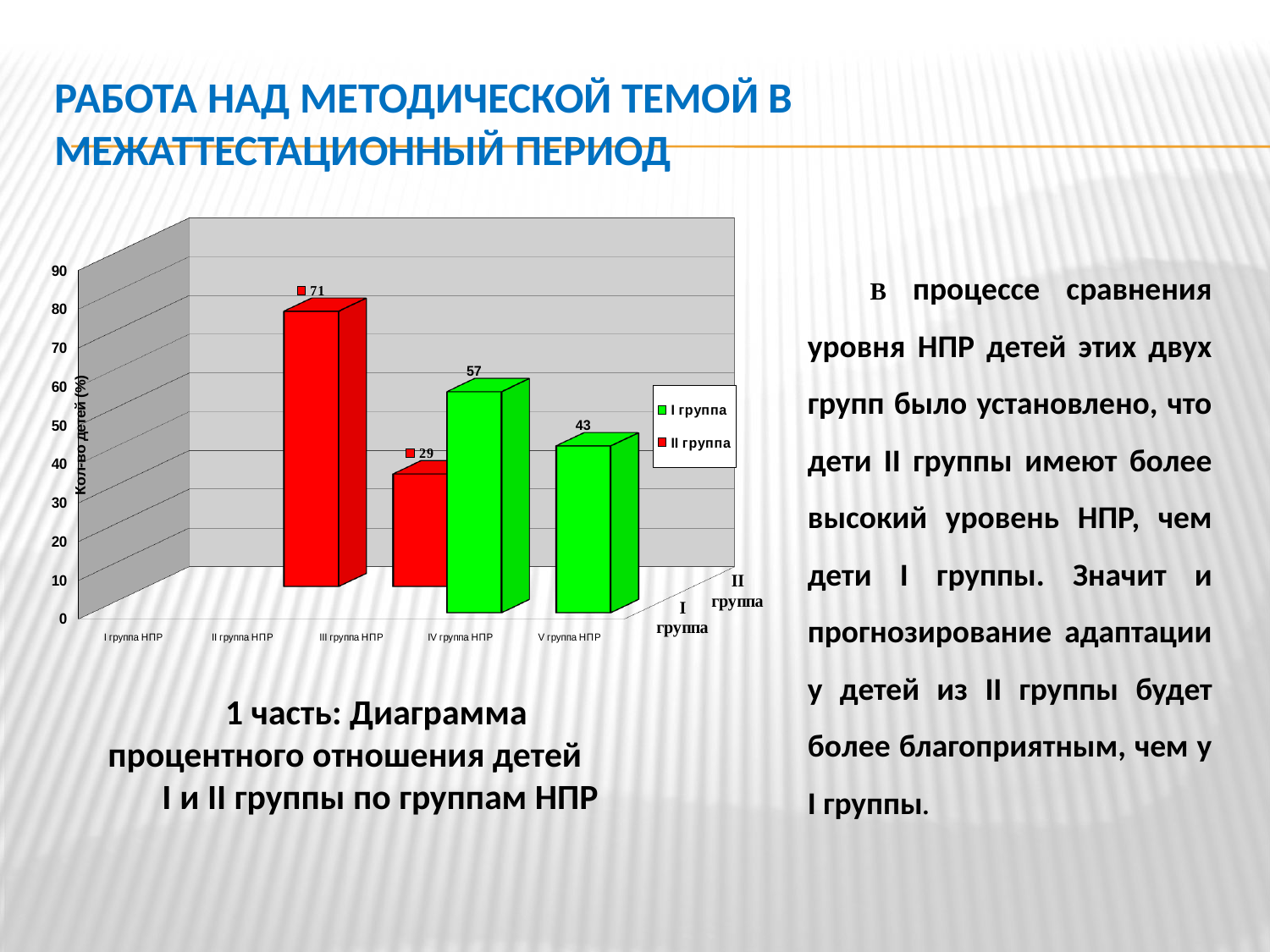
What is the difference between the I группа value for IV группа НПР and the I группа value for V группа НПР? 14 What is the value for I группа in the IV группа НПР category? 57 Which category has the highest value for the II группа series? II группа НПР How many series does the chart legend list? 2 What is the value for I группа in the V группа НПР category? 43 What colour represents the I группа series in the chart? green How many categories are shown on the x axis of the chart? 5 What type of chart is shown on the slide? bar chart What is the value for II группа in the III группа НПР category? 29